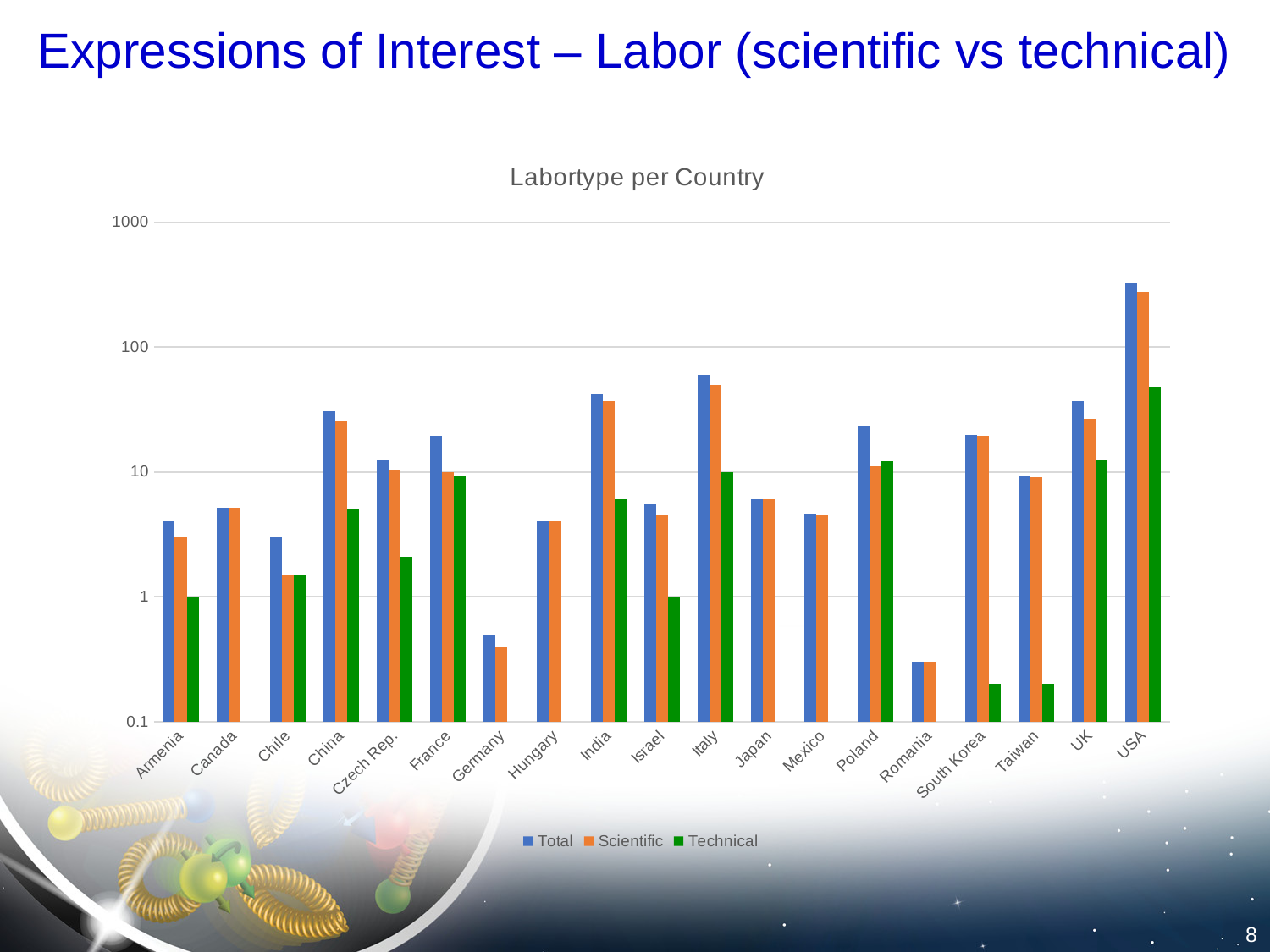
Is the Total value for Germany greater or less than 1? less Which country has the highest Total value? USA What is the title of the chart? Labortype per Country Is the Total value for Italy greater or less than 10? greater Which has the larger Total value, India or Italy? Italy What type of chart is shown on the slide? bar chart Which has the larger Total value, China or France? China How many series does the legend list? 3 Which country has the lowest Total value? Romania Is the Technical value for South Korea greater or less than 1? less How many countries are shown on the x axis? 19